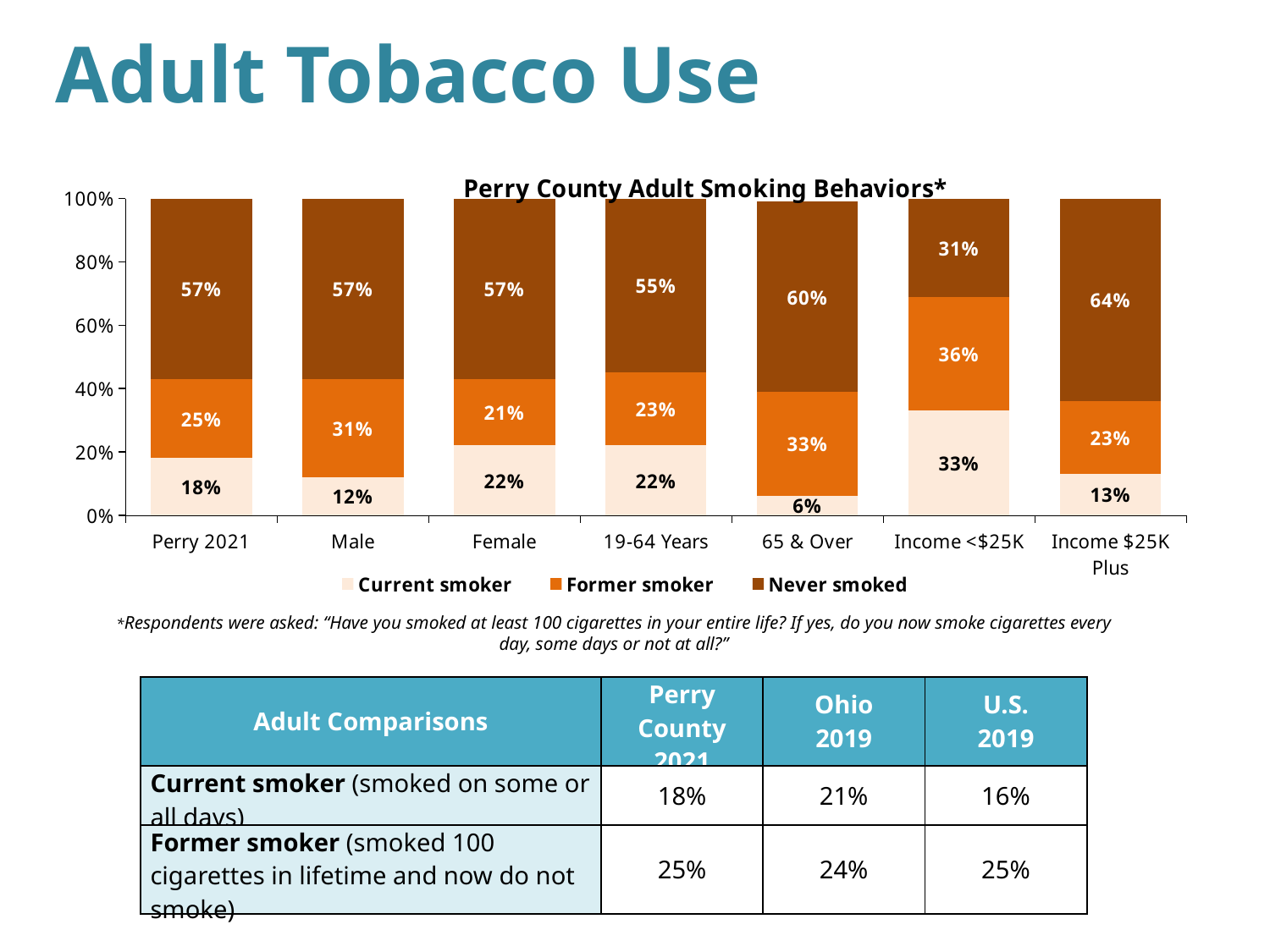
What is the chart's title? Perry County Adult Smoking Behaviors* What is the Never smoked value for 65 & Over? 60% What kind of chart is shown on the slide? Stacked bar chart What is the Former smoker value for Male? 31% Which is larger, the Former smoker value for Female or for 19-64 Years? 19-64 Years Which category has the lowest Current smoker value? 65 & Over How many series does the legend list? 3 How many categories are shown on the x axis? 7 Which category has the highest Never smoked value? Income $25K Plus What is the total of the stacked bar for Perry 2021? 100% What is the Current smoker value for Income <$25K? 33% What is the difference between the Current smoker values for Income <$25K and Income $25K Plus? 20%